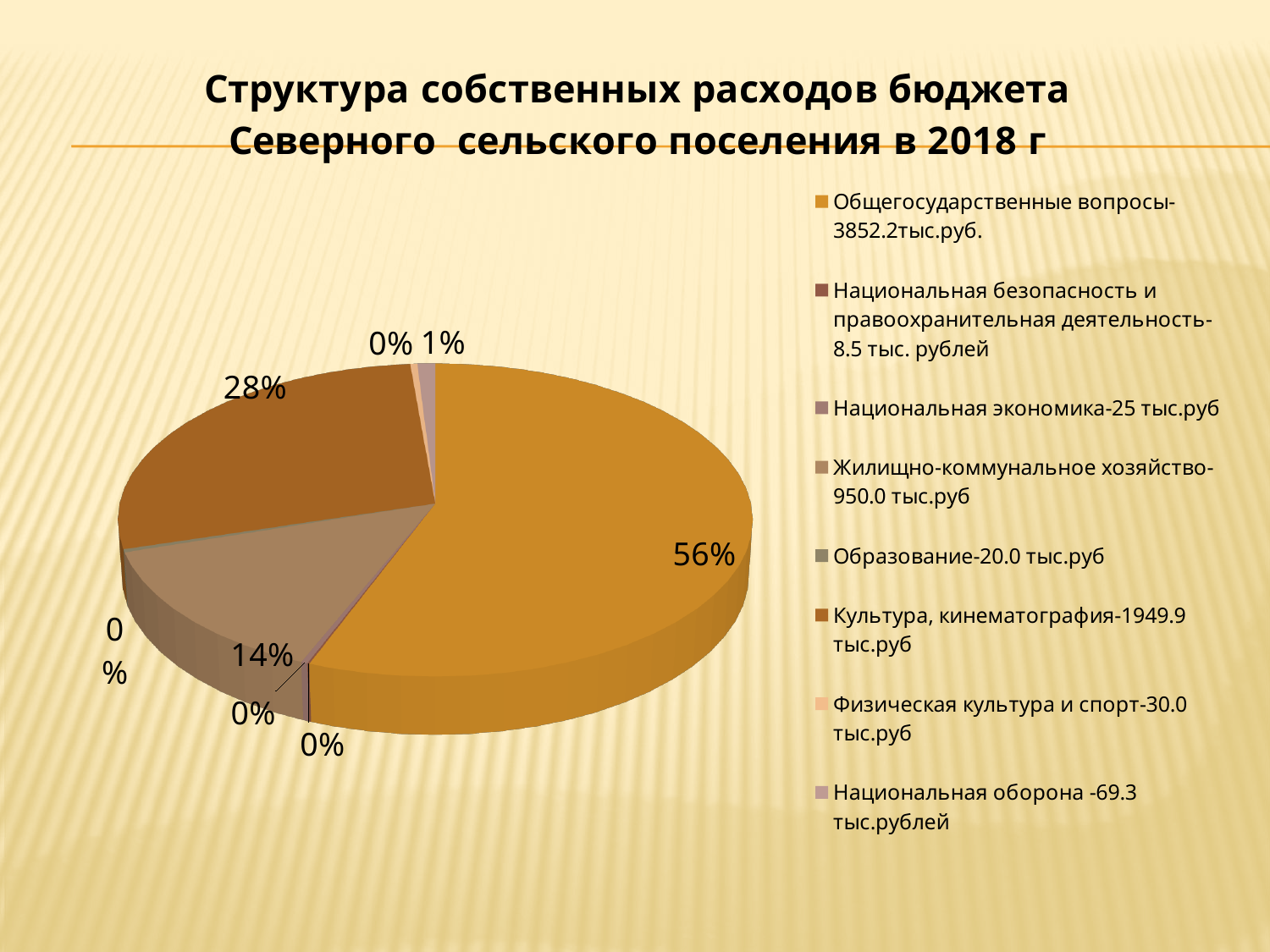
What share of the pie is labelled for Культура, кинематография? 28% What kind of chart is shown on the slide? Pie chart According to the legend, what is the amount for Общегосударственные вопросы? 3852.2тыс.руб. Which has the larger share of the pie: Культура, кинематография or Жилищно-коммунальное хозяйство? Культура, кинематография According to the legend, what is the amount for Национальная безопасность и правоохранительная деятельность? 8.5 тыс. рублей What is the title of the chart on the slide? Структура собственных расходов бюджета Северного сельского поселения в 2018 г What share of the pie does the largest slice represent? 56% Which category has the largest share of the pie? Общегосударственные вопросы What share of the pie is labelled for Жилищно-коммунальное хозяйство? 14% According to the legend, what is the amount for Культура, кинематография? 1949.9 тыс.руб How many categories does the legend of the pie chart list? 8